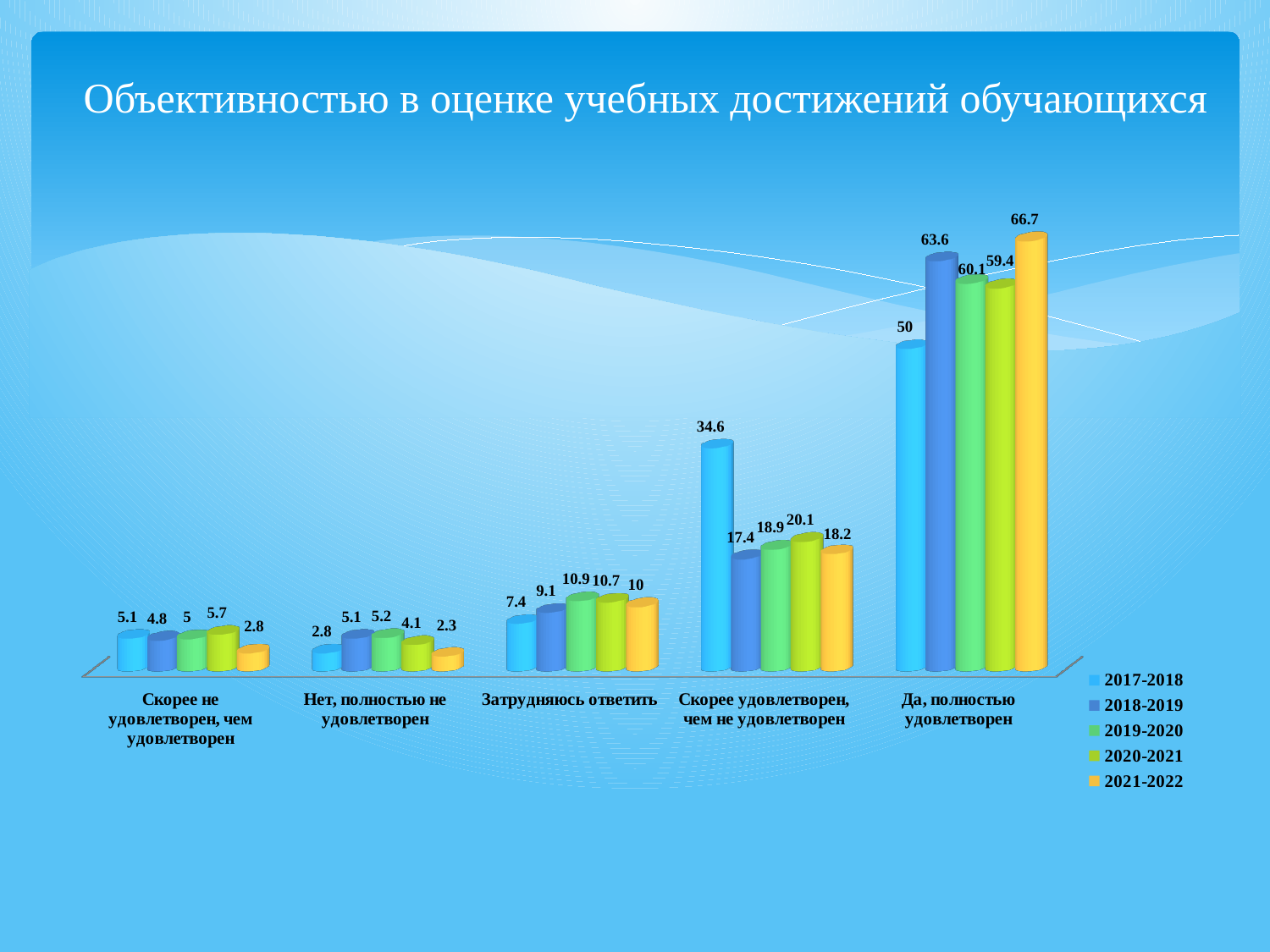
What kind of chart is shown on the slide? Bar chart What is the value for 2019-2020 in the category "Затрудняюсь ответить"? 10.9 Which is larger in the category "Скорее удовлетворен, чем не удовлетворен": the 2017-2018 value or the 2020-2021 value? 2017-2018 Which series has the highest value in the category "Да, полностью удовлетворен"? 2021-2022 How many categories are shown on the x axis? 5 How many series does the legend list? 5 What is the value for 2021-2022 in the category "Да, полностью удовлетворен"? 66.7 What is the difference between the 2018-2019 and 2017-2018 values in the category "Да, полностью удовлетворен"? 13.6 Which legend entry is shown in yellow/orange? 2021-2022 What is the value for 2021-2022 in the category "Нет, полностью не удовлетворен"? 2.3 What is the value for 2017-2018 in the category "Скорее удовлетворен, чем не удовлетворен"? 34.6 Which series has the lowest value in the category "Скорее не удовлетворен, чем удовлетворен"? 2021-2022